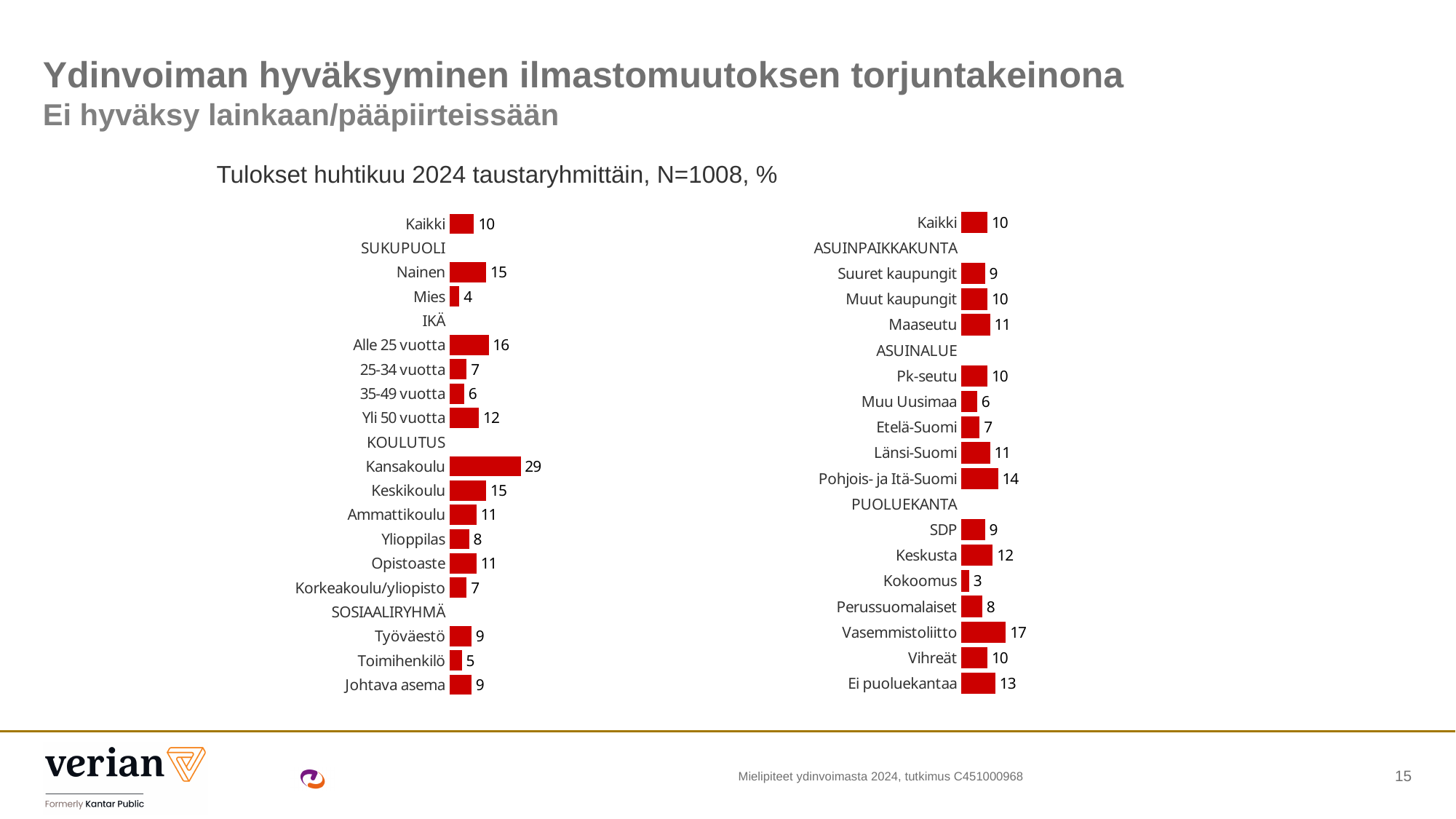
What kind of chart is shown on the left of the slide? Bar chart In the right chart, what is the value for Vasemmistoliitto? 17 In the left chart, what is the difference between the values for Nainen and Mies? 11 In the left chart, which category has the highest value? Kansakoulu In the right chart, what is the difference between the values for Vasemmistoliitto and Kokoomus? 14 In the left chart, what is the value for Kansakoulu? 29 In the left chart, what is the value for Mies? 4 In the right chart, which is larger, the value for Pohjois- ja Itä-Suomi or the value for Etelä-Suomi? Pohjois- ja Itä-Suomi What is the value for Kaikki shown at the top of both charts? 10 In the right chart, which category has the lowest value? Kokoomus In the right chart, what is the value for Ei puoluekantaa? 13 In the left chart, which is larger, the value for Alle 25 vuotta or the value for 35-49 vuotta? Alle 25 vuotta